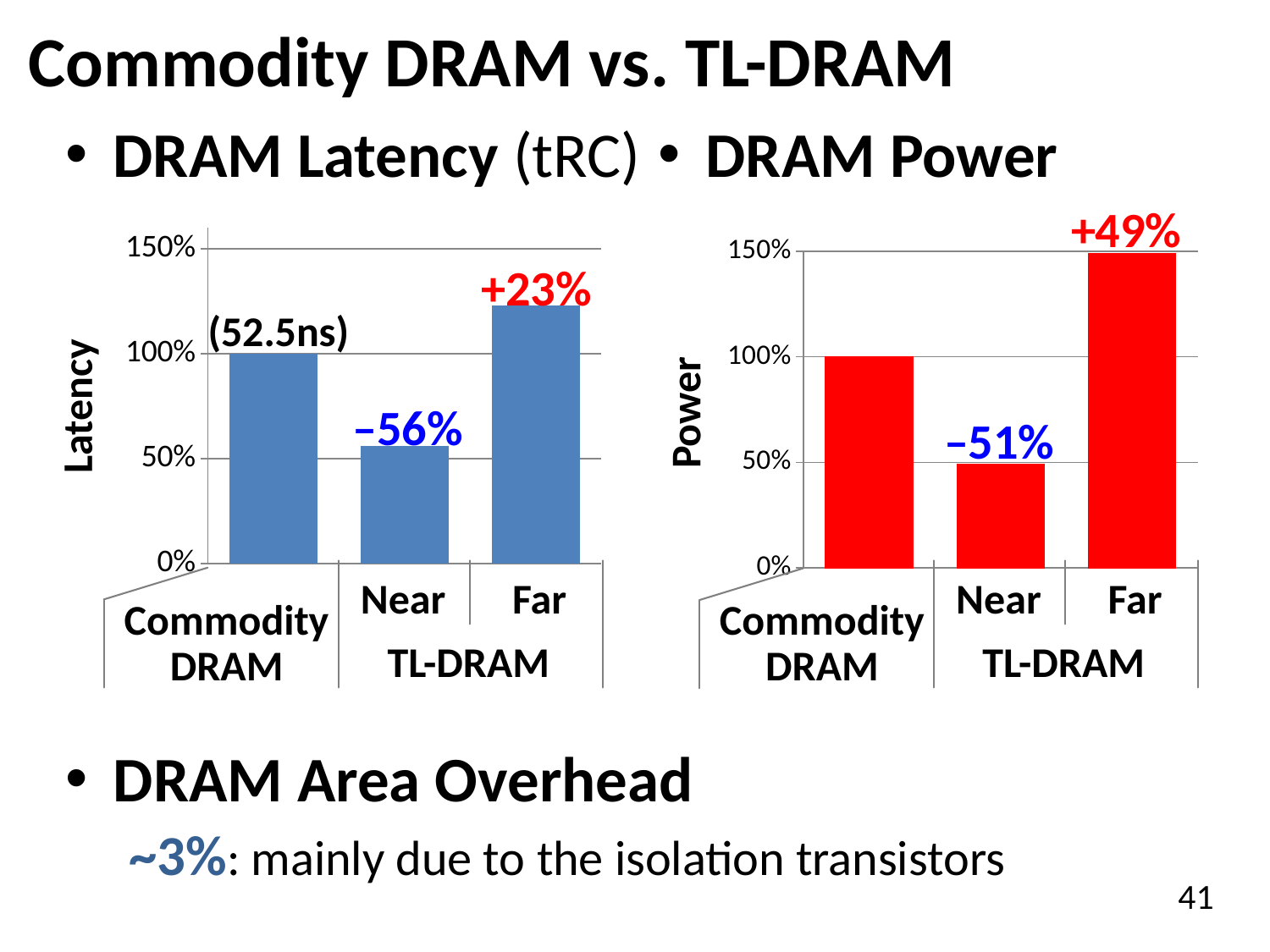
In the DRAM Power chart, which bar is the highest? TL-DRAM Far In the DRAM Latency chart, what absolute latency is given in parentheses for Commodity DRAM? 52.5ns In the DRAM Latency chart, what value does the Commodity DRAM bar reach on the y axis? 100% In the DRAM Latency chart, what kind of chart is used? bar chart In the DRAM Latency chart, which is larger: the Commodity DRAM bar or the TL-DRAM Far bar? TL-DRAM Far In the DRAM Latency chart, how many bars are plotted? 3 In the DRAM Latency chart, what percentage change is labelled on the TL-DRAM Near bar? –56% In the DRAM Power chart, is the value for TL-DRAM Far greater or less than 100%? greater In the DRAM Power chart, what percentage change is labelled on the TL-DRAM Far bar? +49% In the DRAM Power chart, what percentage change is labelled on the TL-DRAM Near bar? –51% In the DRAM Latency chart, what percentage change is labelled on the TL-DRAM Far bar? +23% In the DRAM Latency chart, which bar is the lowest? TL-DRAM Near